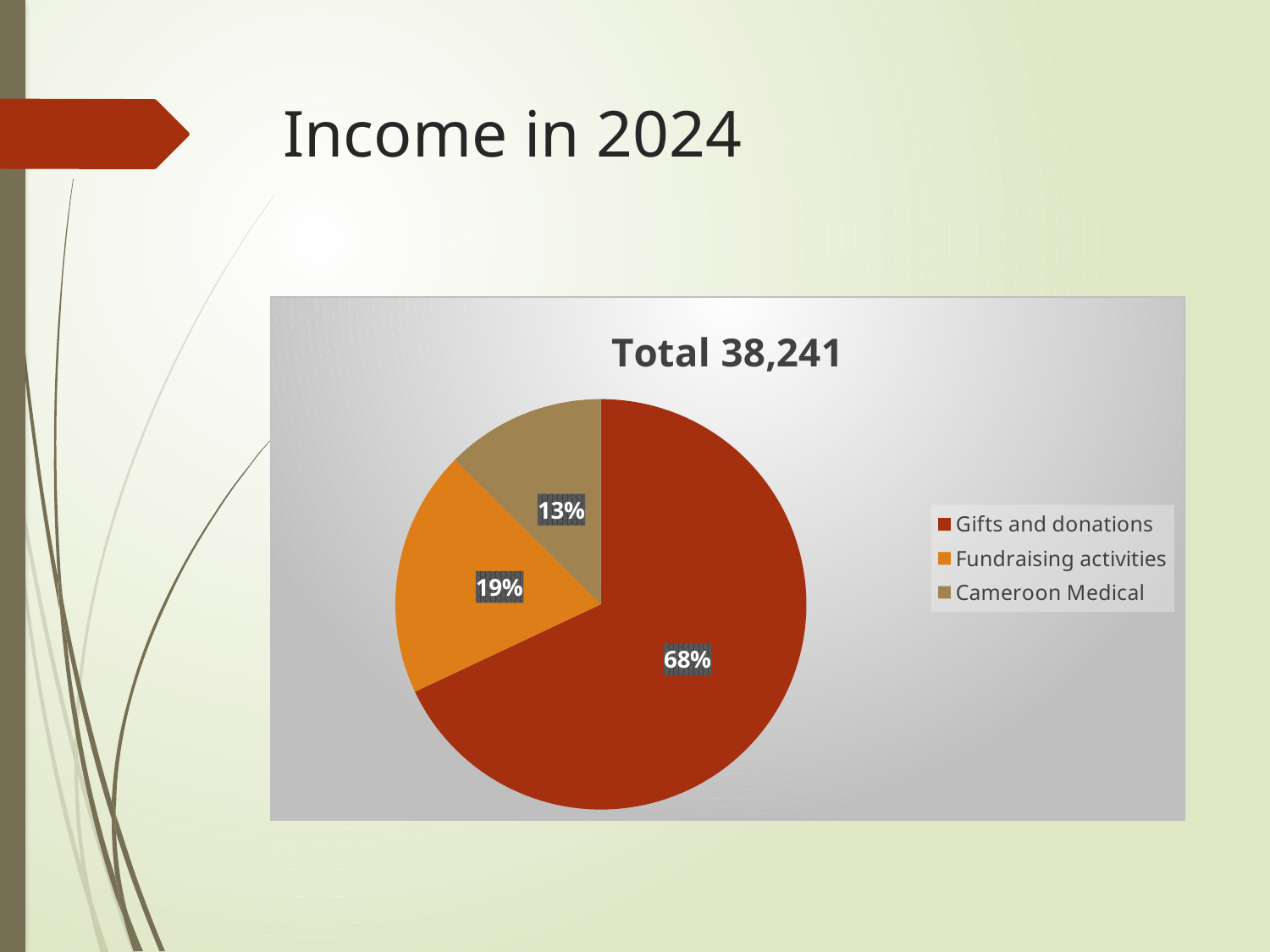
Which is larger, the share for Fundraising activities or the share for Cameroon Medical? Fundraising activities How many categories are shown in the pie chart? 3 Which category has the smallest slice of the pie? Cameroon Medical What kind of chart is shown on the slide? Pie chart What is the difference in percentage points between Fundraising activities and Cameroon Medical? 6 What share of the pie does Gifts and donations represent? 68% What share of the pie does Cameroon Medical represent? 13% Which category is shown in orange in the legend? Fundraising activities Which category has the largest slice of the pie? Gifts and donations What is the title of the chart? Total 38,241 What is the difference in percentage points between Gifts and donations and Fundraising activities? 49 What share of the pie does Fundraising activities represent? 19%